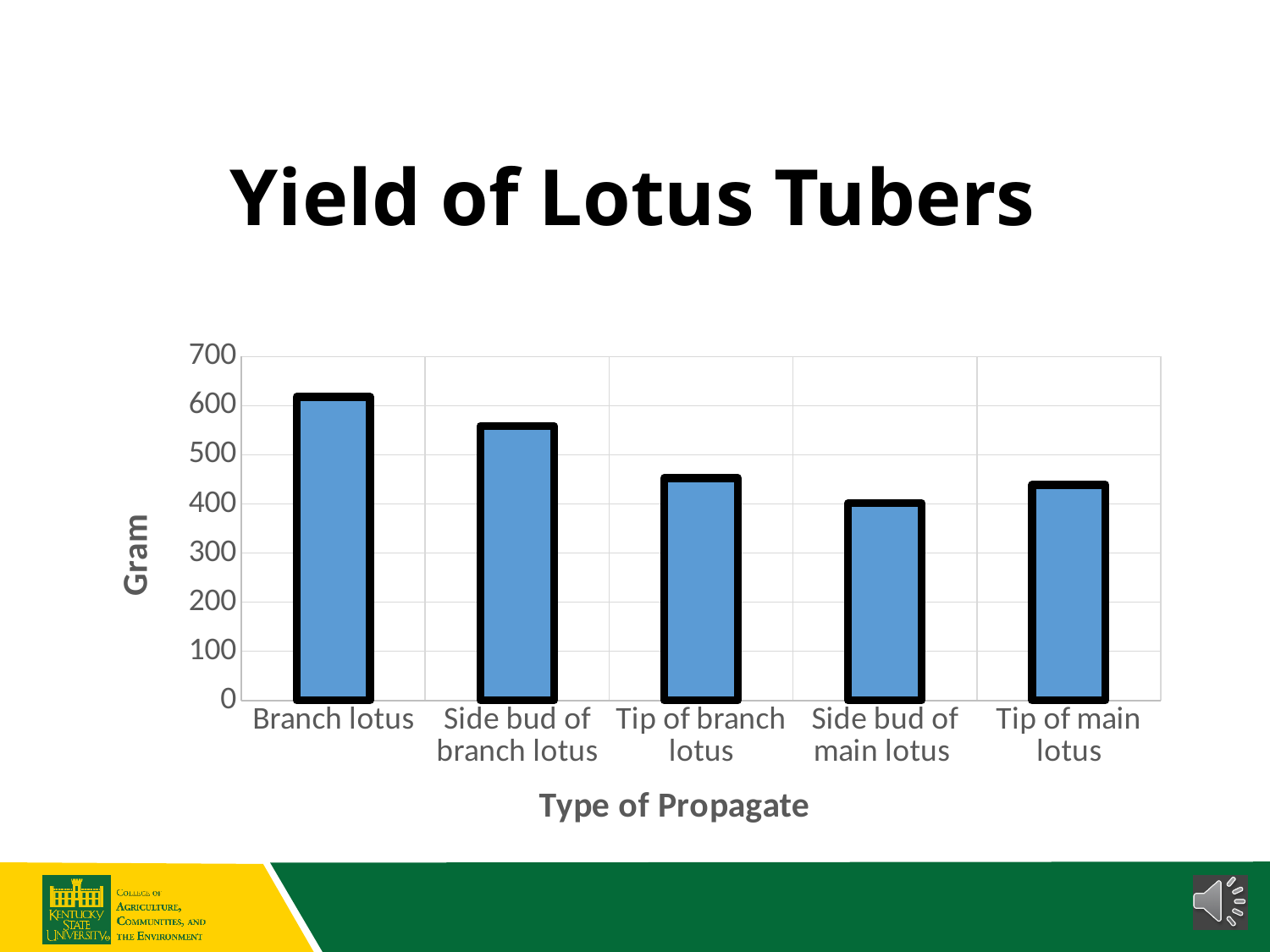
What is the label on the y axis of the chart? Gram Is the value for Branch lotus greater or less than 600? greater Is the value for Side bud of branch lotus greater or less than 500? greater Is the value for Tip of main lotus greater or less than 400? greater How many types of propagate are shown on the x axis? 5 Which type of propagate has the highest yield of lotus tubers? Branch lotus Which type of propagate has the lowest yield of lotus tubers? Side bud of main lotus Which has a higher yield, Branch lotus or Tip of main lotus? Branch lotus Which has a higher yield, Side bud of branch lotus or Tip of branch lotus? Side bud of branch lotus What kind of chart is shown on the slide? Bar chart